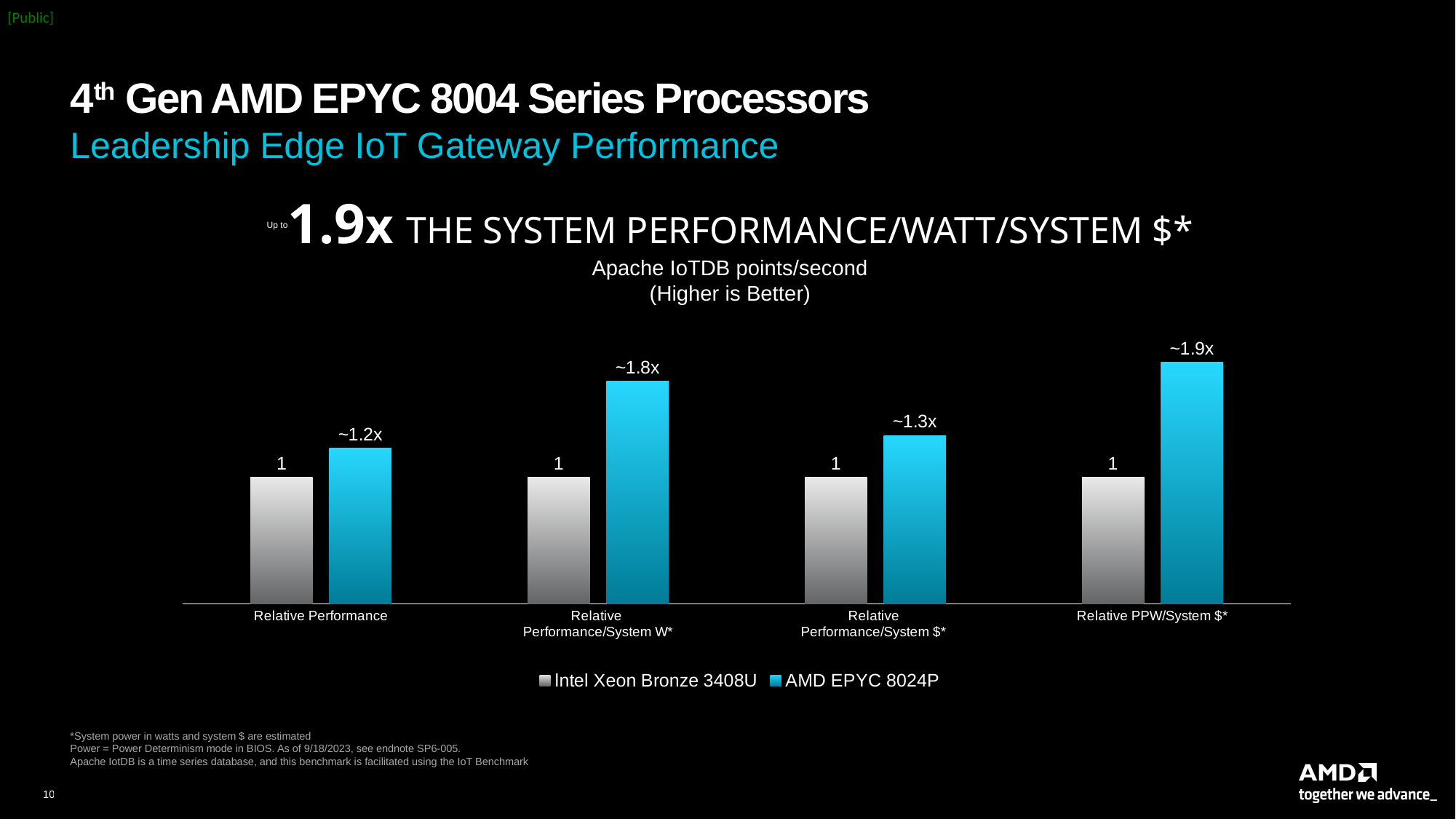
What is the data label for AMD EPYC 8024P in the Relative PPW/System $* category? ~1.9x What kind of chart is shown on the slide? bar chart What is the data label for AMD EPYC 8024P in the Relative Performance category? ~1.2x What is the data label for AMD EPYC 8024P in the Relative Performance/System W* category? ~1.8x What is the data label for Intel Xeon Bronze 3408U in the Relative Performance category? 1 What is the data label for AMD EPYC 8024P in the Relative Performance/System $* category? ~1.3x In which category is the AMD EPYC 8024P bar highest? Relative PPW/System $* In which category is the AMD EPYC 8024P bar lowest? Relative Performance Which two series are listed in the chart legend? Intel Xeon Bronze 3408U and AMD EPYC 8024P Which is larger for AMD EPYC 8024P: Relative Performance/System W* or Relative Performance/System $*? Relative Performance/System W* How many categories are shown on the x axis? 4 How many series does the legend list? 2